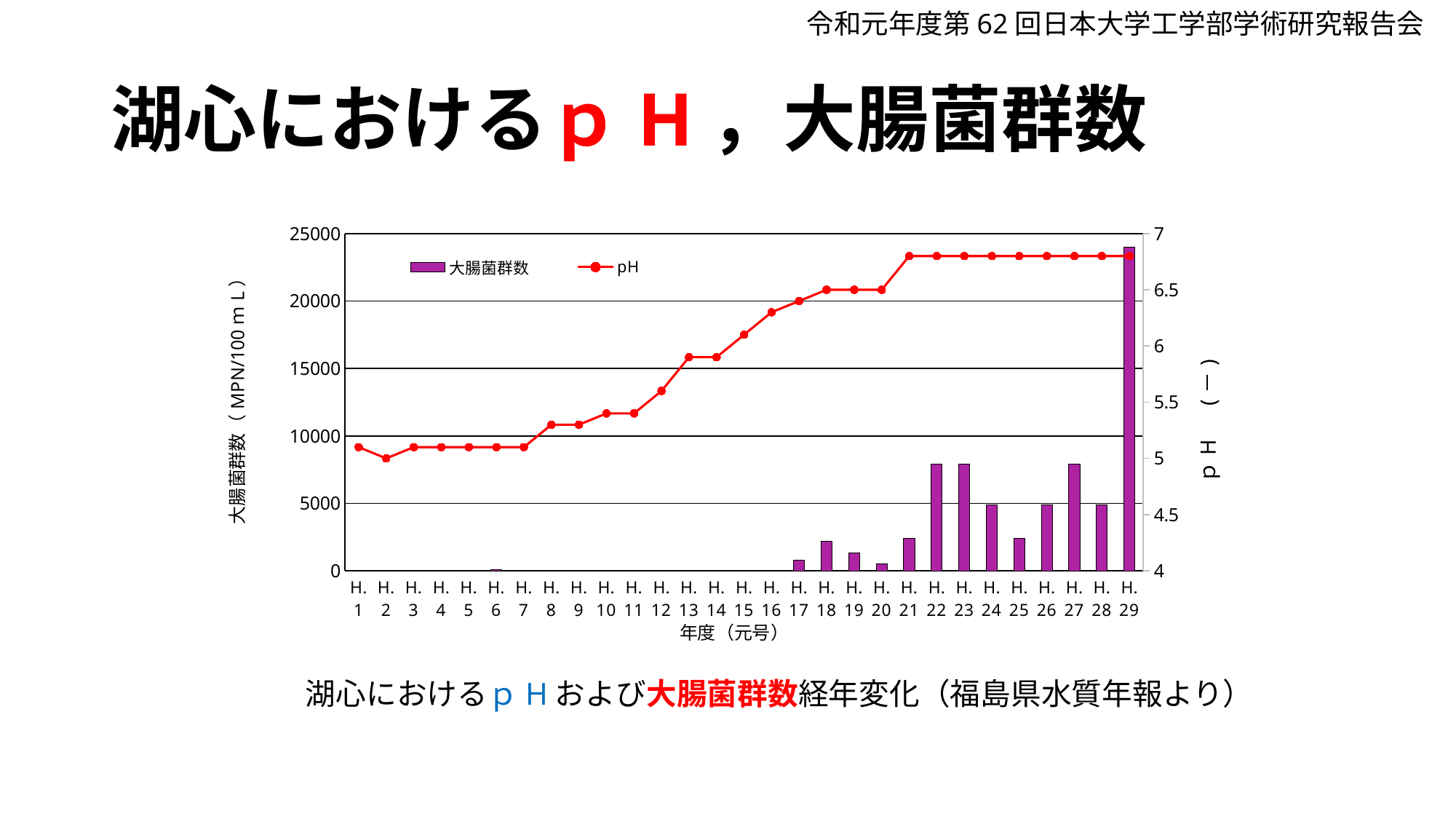
What kind of chart is shown on the slide? Combined bar and line chart How many series does the chart legend list? 2 Is the pH value for H.1 greater or less than 5.5? less Is the 大腸菌群数 value for H.22 greater or less than 10000? less Which is larger, the pH value for H.1 or for H.29? H.29 Which is larger, the 大腸菌群数 bar for H.22 or for H.24? H.22 How many year categories are shown on the x axis of the chart? 29 Does the pH line generally rise or fall from H.1 to H.29? rise What is the label of the left vertical axis of the chart? 大腸菌群数（MPN/100 mL） Is the 大腸菌群数 value for H.29 greater or less than 20000? greater Which year has the highest 大腸菌群数 bar? H.29